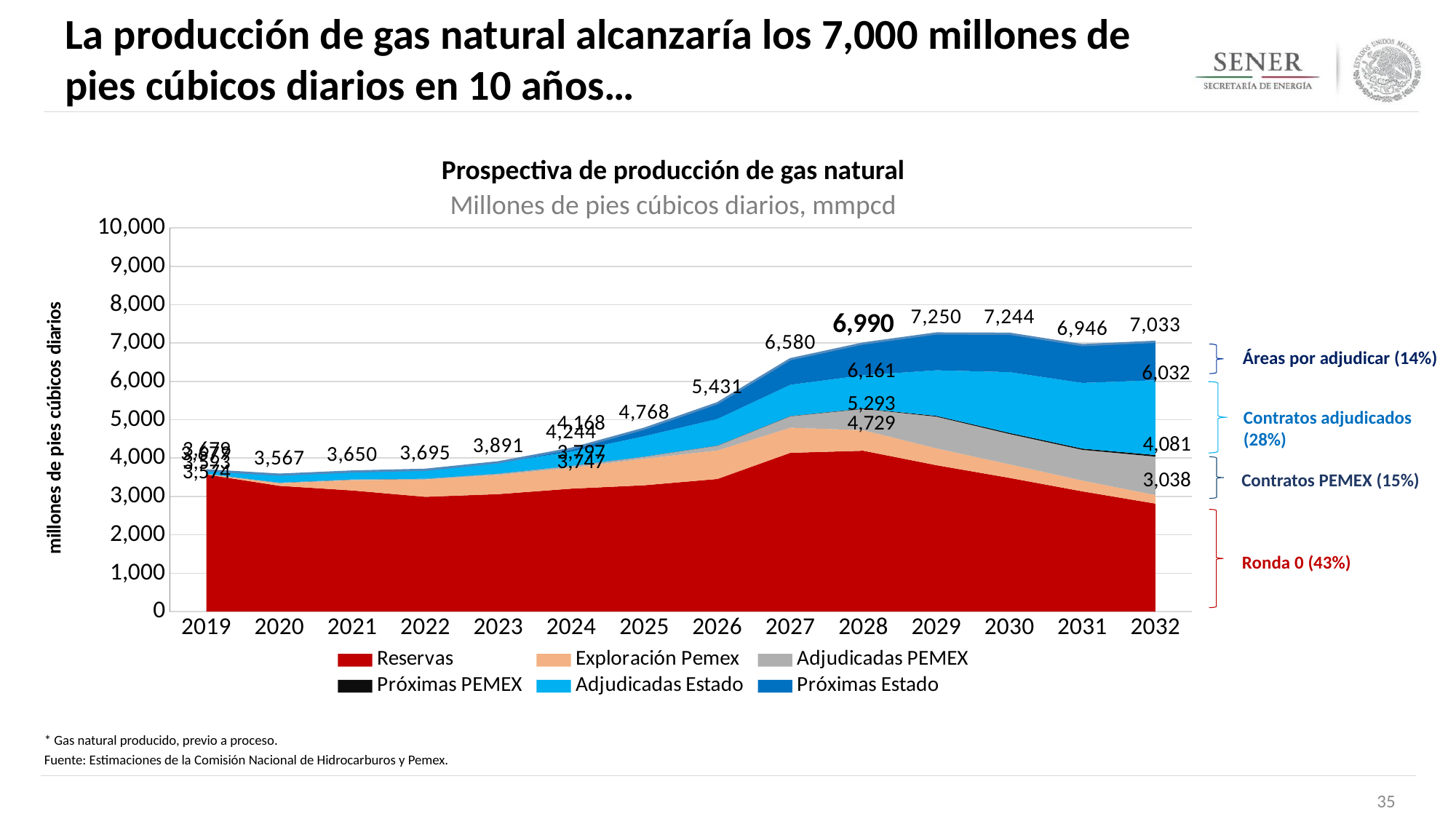
Does total production rise or fall from 2022 to 2029? rise Which year has the lowest total production label? 2020 Which year has the larger total production label, 2027 or 2028? 2028 What is the total natural gas production labelled for 2029? 7,250 What is the difference between the total production labels for 2030 and 2031? 298 How many years are shown on the x axis? 14 How many series does the legend list? 6 Which series is shown in red in the legend? Reservas What is the total natural gas production labelled for 2020? 3,567 What kind of chart is shown on the slide? area chart What is the total natural gas production labelled for 2032? 7,033 Which year has the highest total production label? 2029